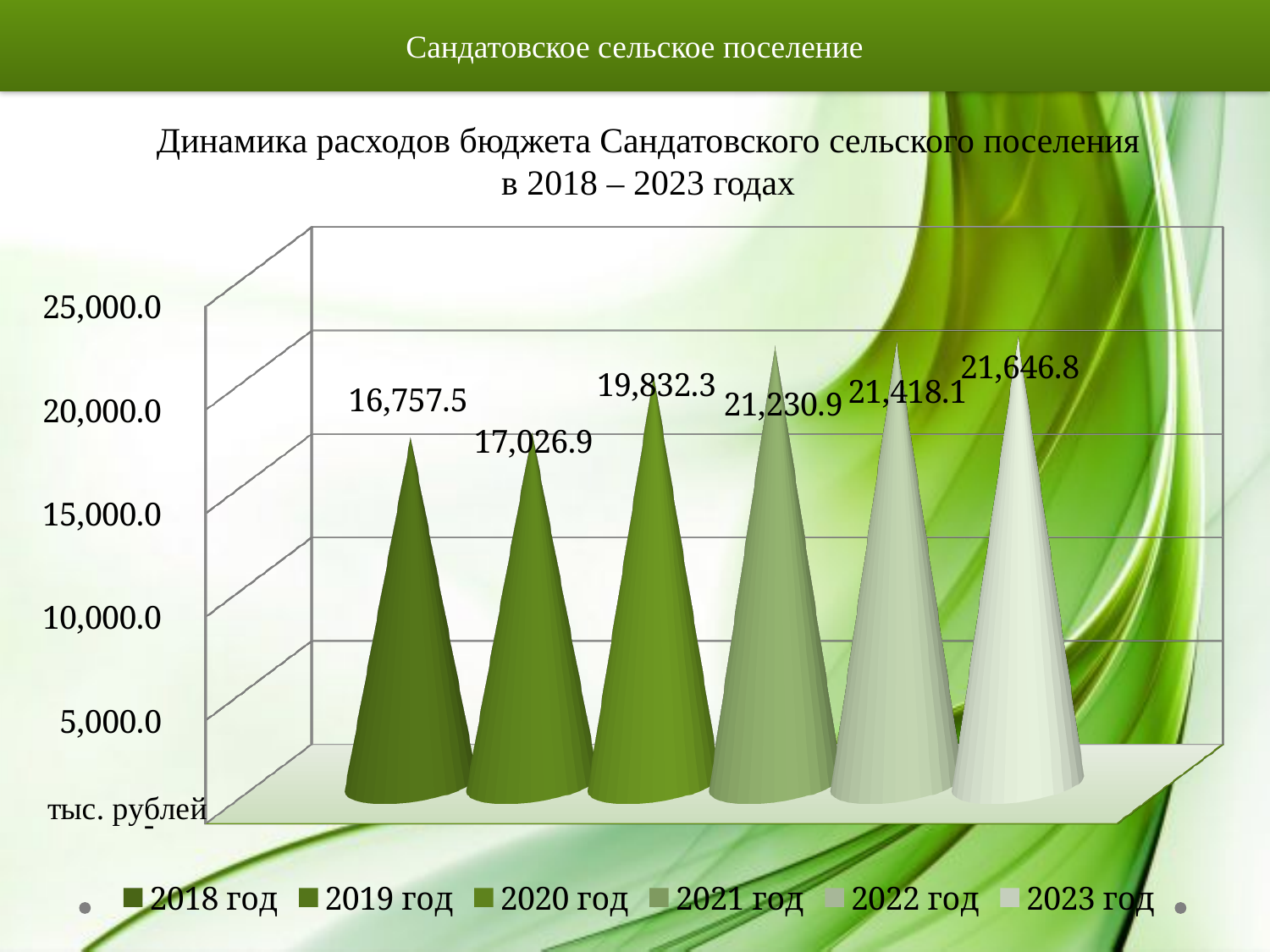
What is the difference between the values for 2020 год and 2019 год? 2,805.4 What is the budget expenditure value for 2020 год? 19,832.3 How many series does the legend list? 6 What is the difference between the values for 2023 год and 2018 год? 4,889.3 Which is larger, the value for 2021 год or the value for 2019 год? 2021 год What is the budget expenditure value for 2023 год? 21,646.8 Do the values rise or fall from 2018 год to 2023 год? rise What is the budget expenditure value for 2018 год? 16,757.5 Is the value for 2022 год greater or less than 20,000.0? greater Which year has the highest budget expenditure value? 2023 год Which year has the lowest budget expenditure value? 2018 год What kind of chart is shown on the slide? bar chart